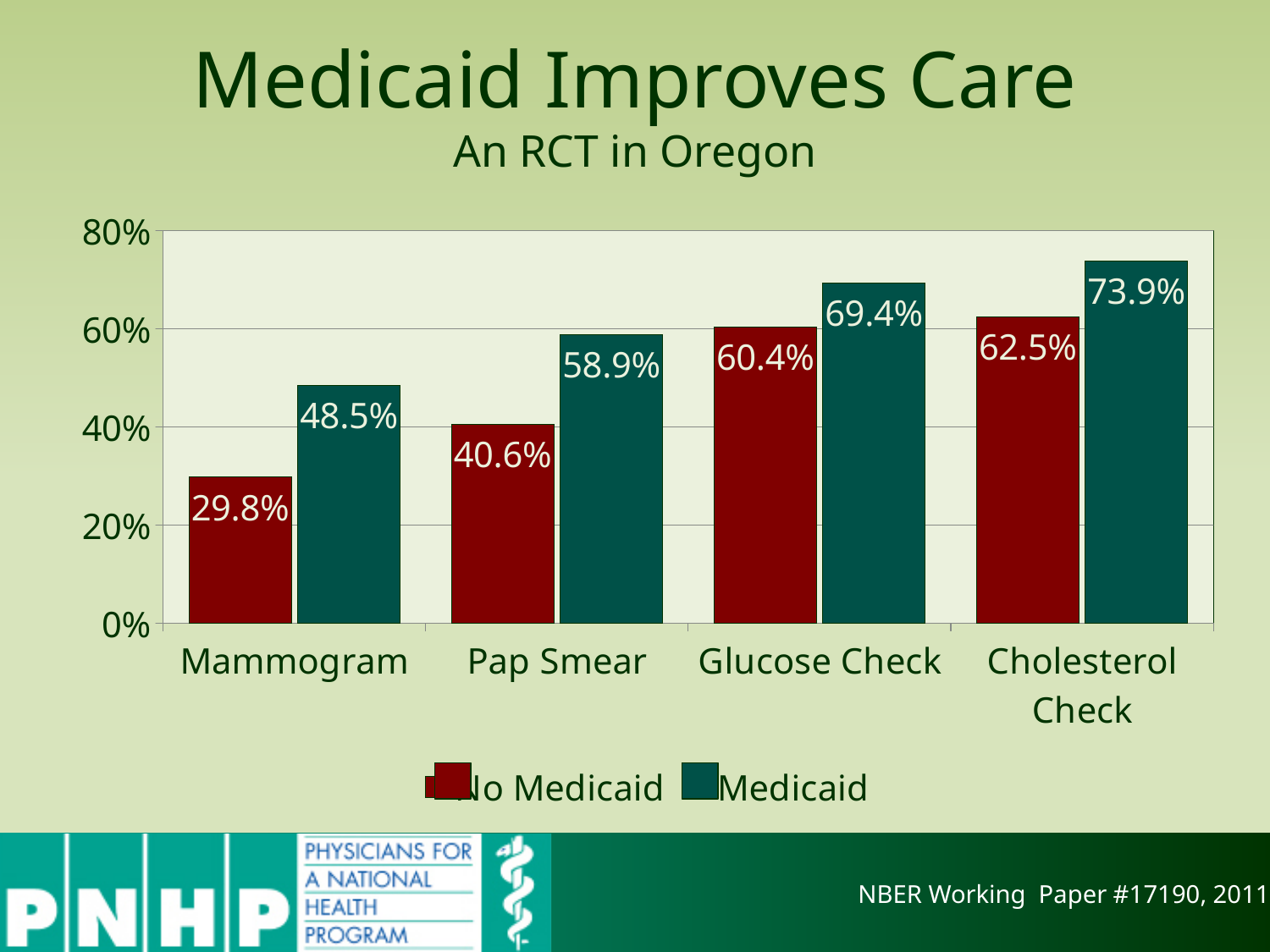
Which is larger for Pap Smear, the Medicaid value or the No Medicaid value? Medicaid What kind of chart is shown on the slide? Bar chart What is the No Medicaid value for Glucose Check? 60.4% What is the Medicaid value for Cholesterol Check? 73.9% How many categories are shown on the x axis? 4 What is the No Medicaid value for Pap Smear? 40.6% How many series does the legend list? 2 Which category has the highest Medicaid value? Cholesterol Check What is the Medicaid value for Mammogram? 48.5% Do the No Medicaid values rise or fall from Mammogram to Cholesterol Check? Rise What is the difference between the Medicaid and No Medicaid values for Mammogram? 18.7% Which category has the lowest No Medicaid value? Mammogram